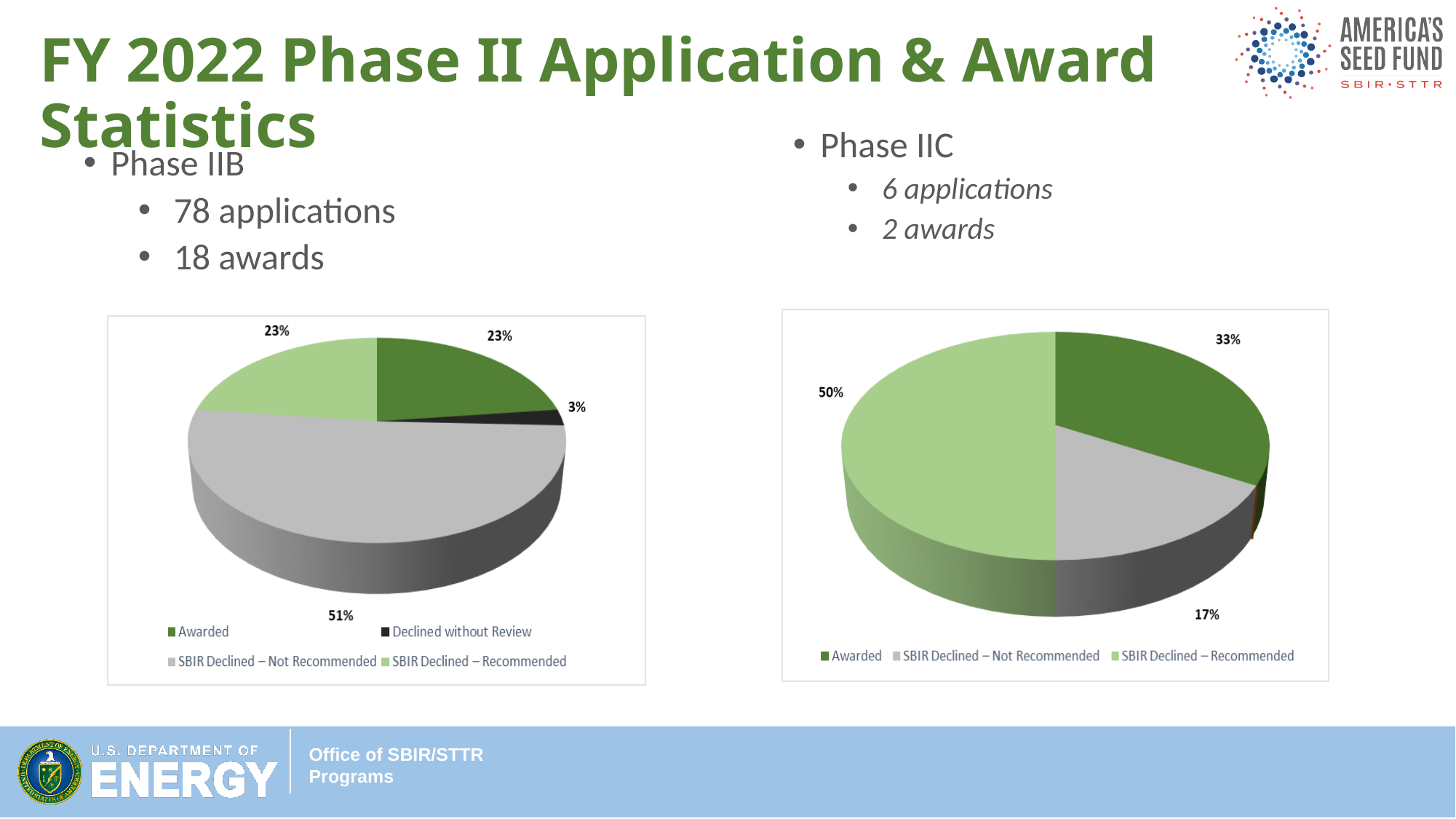
How many categories does the legend of the left pie chart list? 4 In the right pie chart, what is the difference in percentage points between the SBIR Declined – Recommended slice and the Awarded slice? 17 In the right pie chart, which category has the smallest slice? SBIR Declined – Not Recommended In the left pie chart, what share is labelled for Declined without Review? 3% In the left pie chart, which category has the smallest slice? Declined without Review In the right pie chart, what share is labelled for SBIR Declined – Recommended? 50% In the right pie chart, what share is labelled for Awarded? 33% What kind of chart is the left chart on the slide? pie chart In the left pie chart, which category has the largest slice? SBIR Declined – Not Recommended How many categories does the legend of the right pie chart list? 3